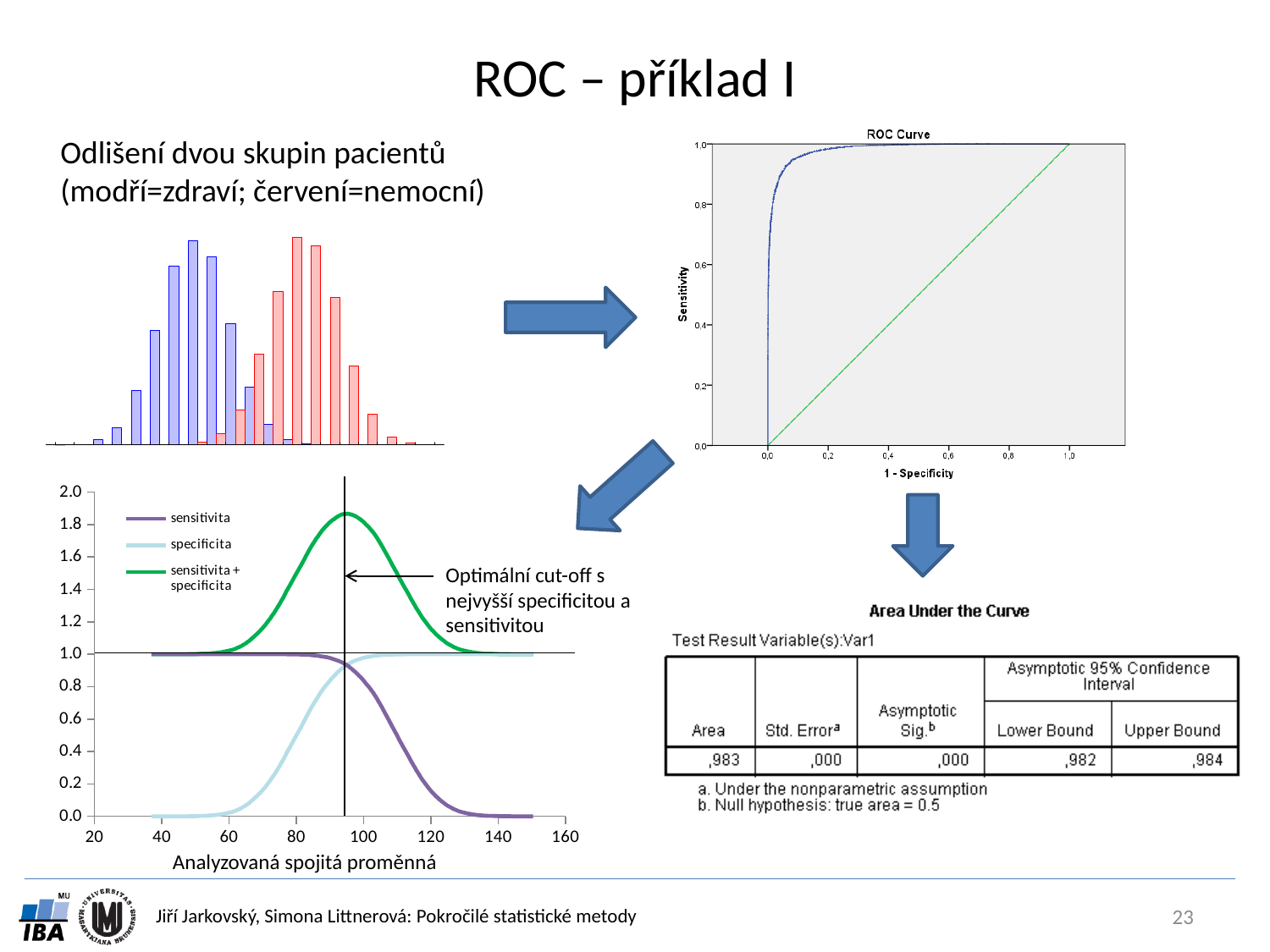
On the bottom-left chart, is the peak value of the sensitivita + specificita curve greater or less than 1.6? greater In the Area Under the Curve table, what is the Upper Bound of the Asymptotic 95% Confidence Interval? ,984 On the bottom-left chart, what is the label of the x axis? Analyzovaná spojitá proměnná What kind of chart is the top-left chart with blue and red bars? bar chart What is the title of the chart in the top-right of the slide? ROC Curve On the bottom-left chart, which series is drawn in green? sensitivita + specificita On the bottom-left chart, is the value of specificita at x = 40 greater or less than 0.2? less In the Area Under the Curve table, what is the value of Area? ,983 On the bottom-left chart, does the specificita curve rise or fall as the x-axis value increases from 60 to 120? rise On the bottom-left chart, how many series does the legend list? 3 On the bottom-left chart, does the sensitivita curve rise or fall as the x-axis value increases from 80 to 140? fall On the bottom-left chart, is the value of sensitivita at x = 60 greater or less than 0.8? greater